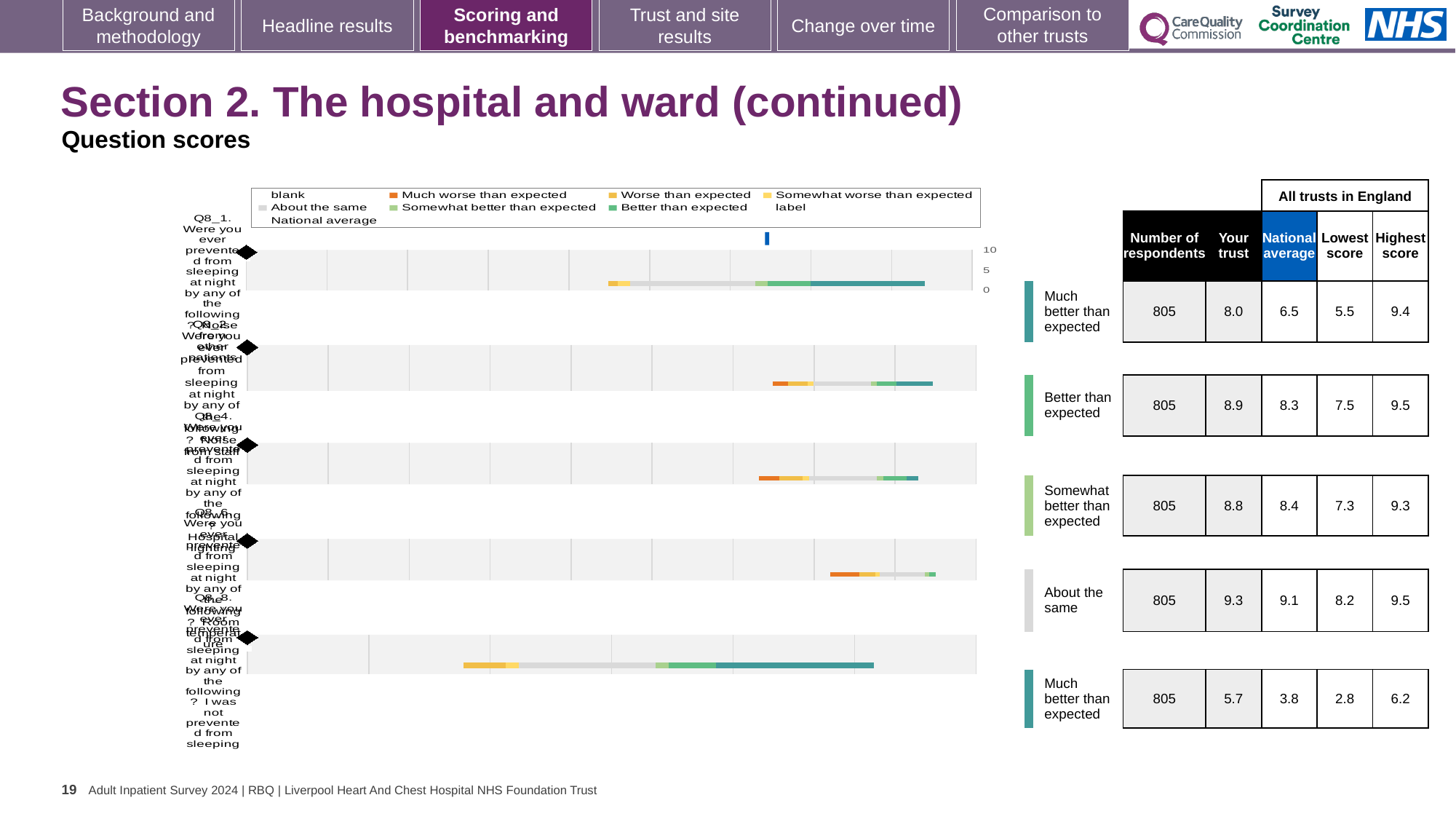
In the table beside the chart, what is the number of respondents for the first row? 805 What kind of chart is shown on the slide? bar chart In the table beside the chart, what is the highest score for the bottom row? 6.2 In the table beside the chart, what is the national average for the row labelled 'About the same'? 9.1 How many entries does the chart legend list? 9 In the table beside the chart, which is larger for the first row: the 'Your trust' score or the national average? Your trust How many horizontal bars (question rows) are plotted in the chart? 5 What is the highest tick value shown on the chart's axis? 10 In the table beside the chart, what is the 'Your trust' score for the row labelled 'Better than expected'? 8.9 In the table beside the chart, which row has the lowest 'Your trust' score? the bottom row (5.7) In the table beside the chart, what is the difference between the 'Your trust' score and the national average in the first row? 1.5 What colour does the legend use for 'Better than expected'? teal